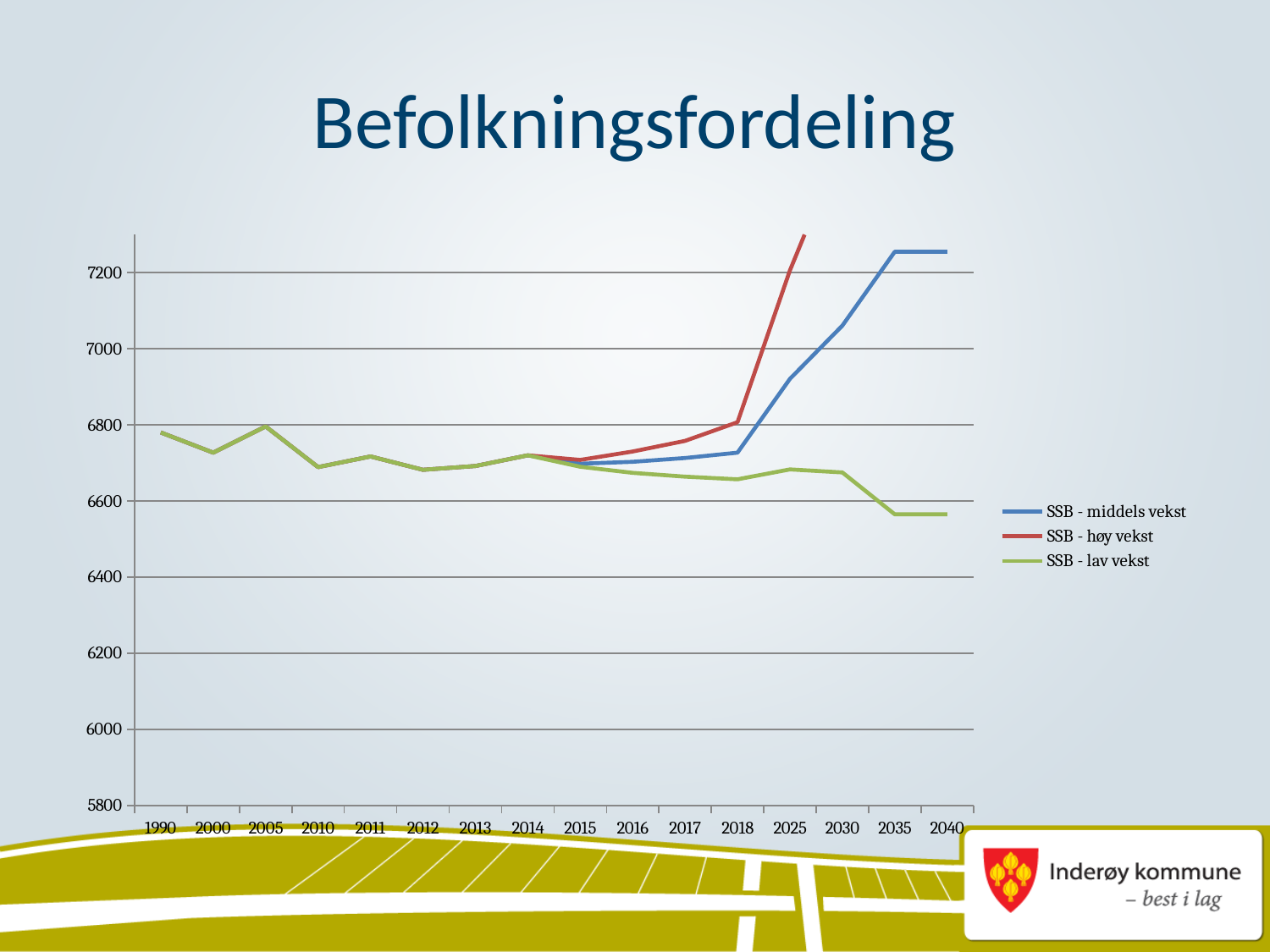
Is the value for SSB - lav vekst in 2040 greater or less than 6600? less What is the title of the chart? Befolkningsfordeling Is the value for SSB - middels vekst in 2040 greater or less than 7200? greater What kind of chart is shown on the slide? line chart How many series does the legend list? 3 Is the value for SSB - lav vekst in 2010 greater or less than 6600? greater Which series is drawn in green? SSB - lav vekst How many years are labelled along the x axis? 16 Does the SSB - middels vekst line rise or fall between 2018 and 2035? rise Which series has the highest value in 2025? SSB - høy vekst Which series has the lowest value in 2030? SSB - lav vekst